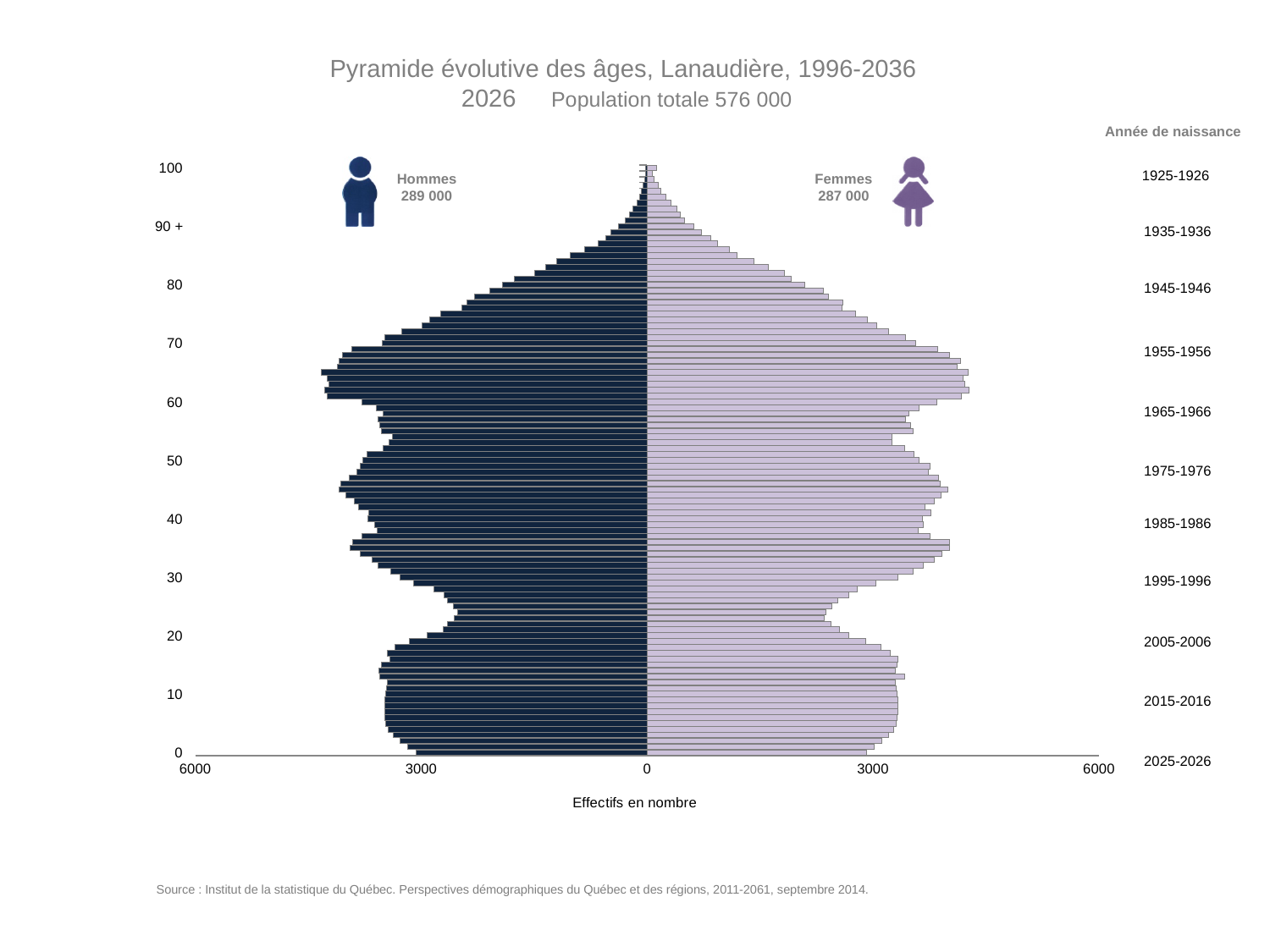
What is the label of the horizontal axis? Effectifs en nombre What kind of chart is shown on the slide? bar chart Which group has the larger total, Hommes or Femmes? Hommes What is the total population shown for 2026? 576 000 Is the value for Femmes at age 90 greater or less than 3000? less Is the value for Hommes at age 65 greater or less than 3000? greater Do the bar lengths rise or fall as age increases from 70 to 100? fall What is the difference between the Hommes total and the Femmes total? 2 000 What is the total number of Hommes shown on the chart? 289 000 Is the value for Femmes at age 35 greater or less than 3000? greater What is the total number of Femmes shown on the chart? 287 000